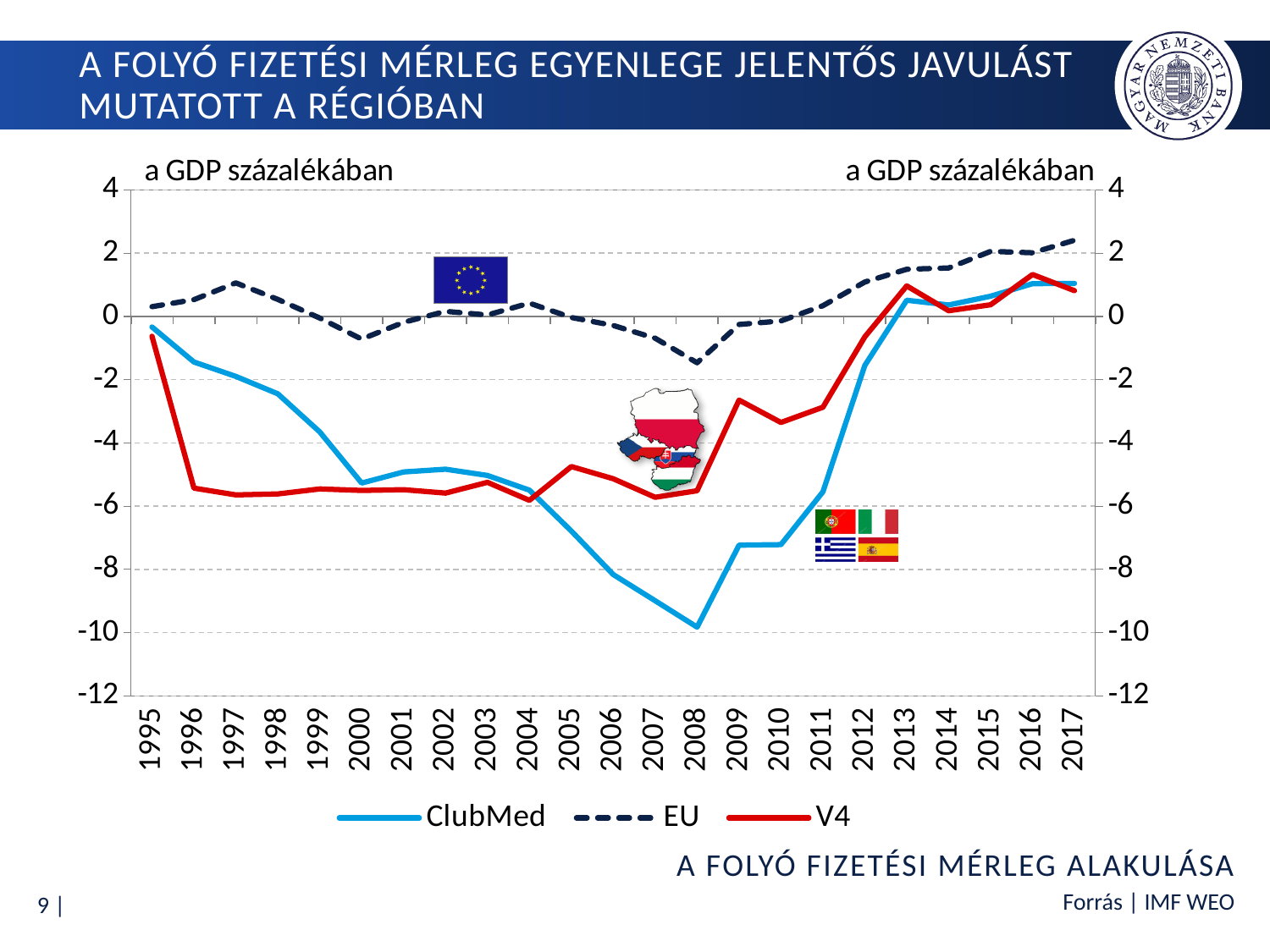
In 2010, which series has a higher value, ClubMed or V4? V4 Is the value for ClubMed in 2008 greater or less than -8? less How many series does the legend list? 3 Is the value for V4 in 1996 greater or less than -4? less How many years are shown on the x axis of the chart? 23 Does the ClubMed line rise or fall between 2008 and 2013? rise In 2008, which series has a higher value, ClubMed or V4? V4 Is the value for EU in 2008 greater or less than 0? less Which series has the lowest value in 2008? ClubMed Which series has the highest value in 2017? EU What kind of chart is shown on the slide? line chart